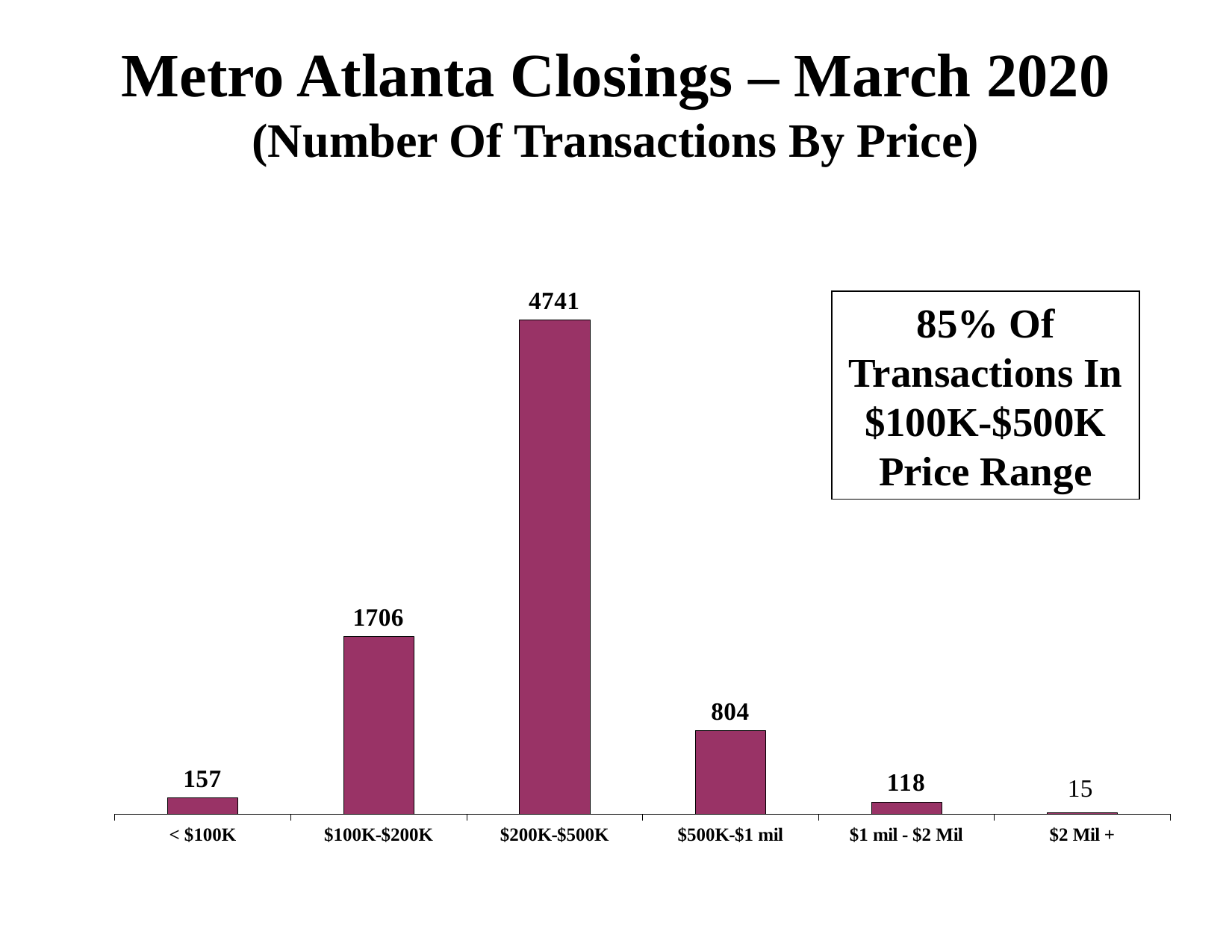
How many transactions were in the < $100K price range? 157 How many price range categories are shown on the chart? 6 What is the total number of transactions across all price ranges shown? 7541 Which had more transactions, the < $100K range or the $1 mil - $2 Mil range? < $100K According to the text box on the slide, what percentage of transactions were in the $100K-$500K price range? 85% Which price range had the lowest number of transactions? $2 Mil + What is the difference in transactions between the $200K-$500K and $100K-$200K price ranges? 3035 How many transactions were in the $500K-$1 mil price range? 804 Which price range had the highest number of transactions? $200K-$500K What kind of chart is shown on the slide? Bar chart What is the difference in transactions between the $1 mil - $2 Mil and $2 Mil + price ranges? 103 How many transactions were in the $200K-$500K price range? 4741